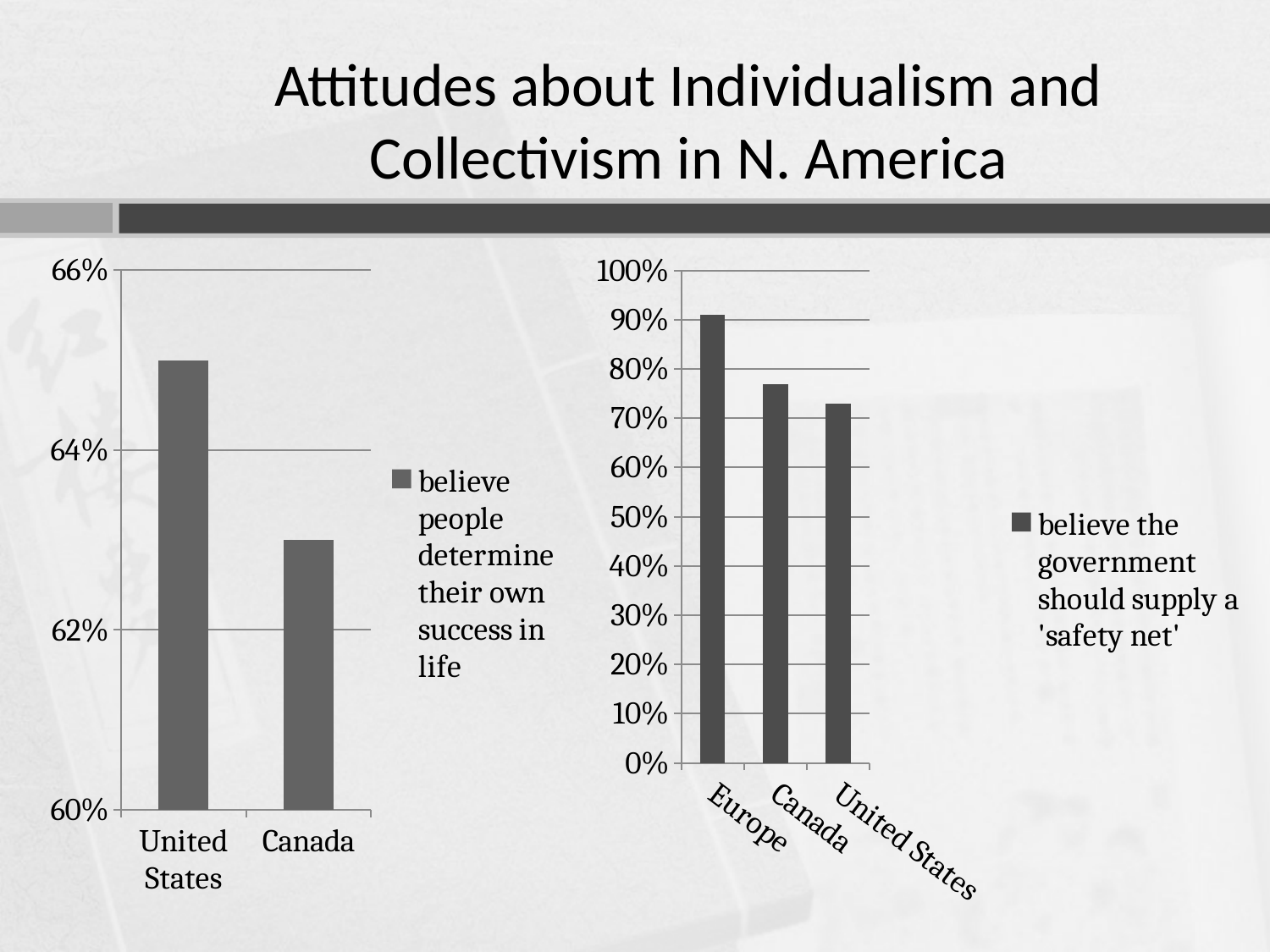
On the left chart, is the value for Canada greater or less than 64%? less On the right chart, which category has the lowest value? United States What kind of chart is the right chart? bar chart On the right chart, is the value for United States greater or less than 70%? greater On the left chart, what series does the legend list? believe people determine their own success in life On the left chart, which category has the higher value, United States or Canada? United States On the left chart, how many categories are shown on the x axis? 2 On the right chart, which category has the highest value? Europe On the right chart, is the value for Europe greater or less than 80%? greater On the right chart, how many categories are shown on the x axis? 3